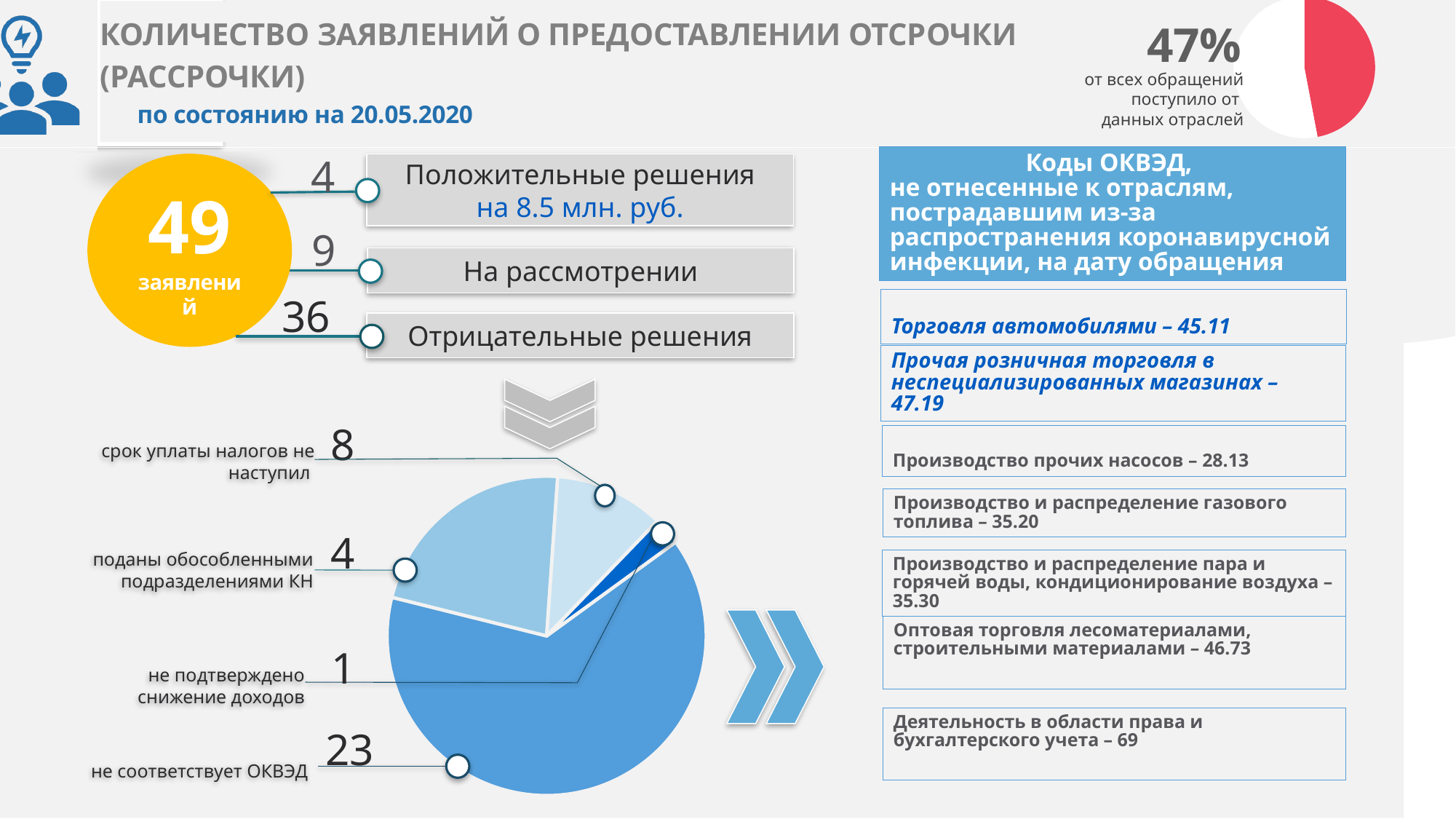
What kind of chart is shown in the lower left of the slide? pie chart What is the total of all four values shown in the pie chart? 36 What is the value for "не соответствует ОКВЭД" in the pie chart? 23 How many slices does the pie chart have? 4 What is the value for "срок уплаты налогов не наступил" in the pie chart? 8 Which category has the smallest slice in the pie chart? не подтверждено снижение доходов What is the value for "поданы обособленными подразделениями КН" in the pie chart? 4 What is the difference between the values for "не соответствует ОКВЭД" and "срок уплаты налогов не наступил" in the pie chart? 15 Which category has the largest slice in the pie chart? не соответствует ОКВЭД What is the value for "не подтверждено снижение доходов" in the pie chart? 1 What percentage is shown next to the small pie chart in the top right corner of the slide? 47% Which is larger in the pie chart: "срок уплаты налогов не наступил" or "поданы обособленными подразделениями КН"? срок уплаты налогов не наступил